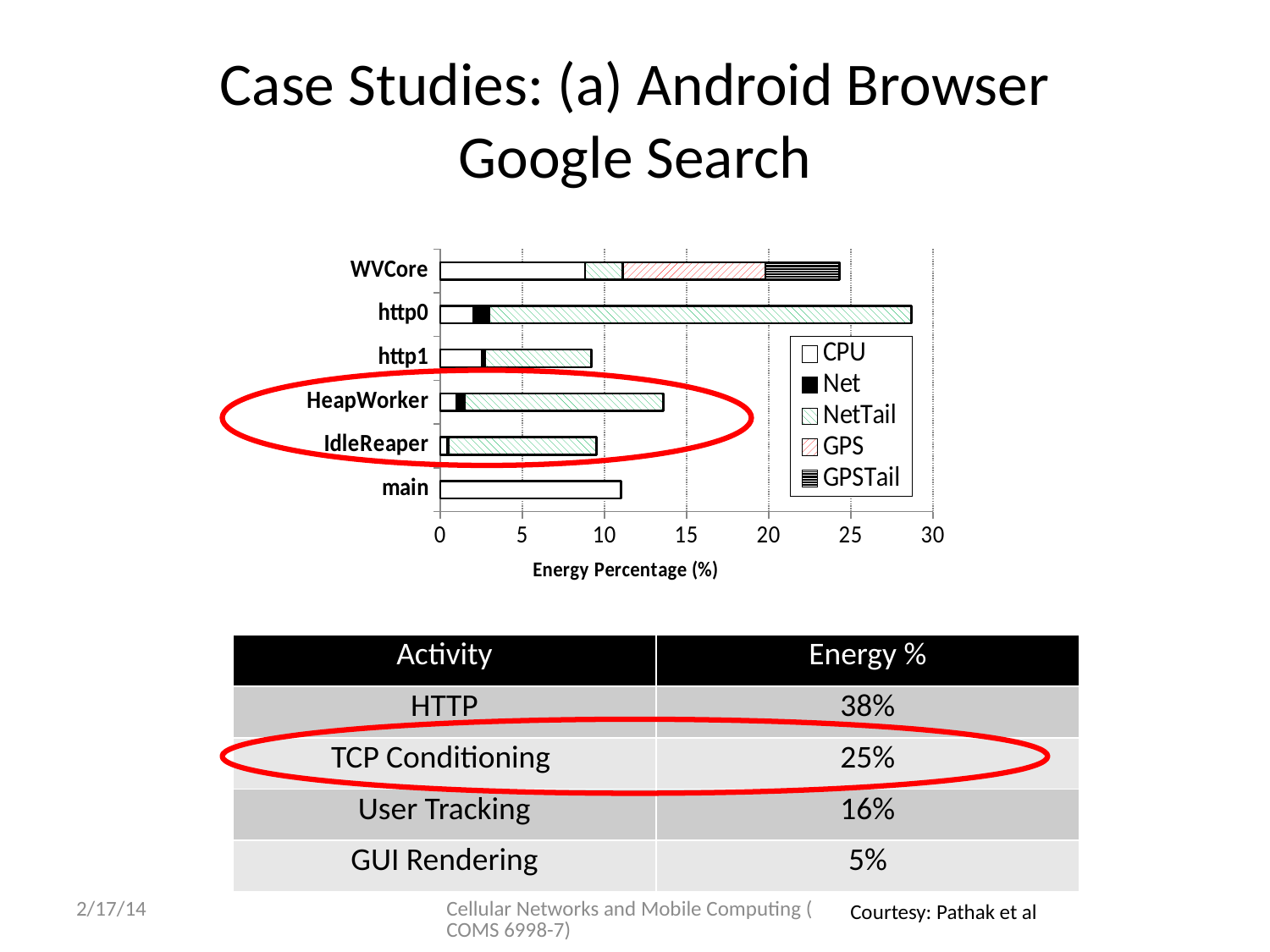
Is the total bar for WVCore greater or less than 20? greater Which has the longer total bar, HeapWorker or main? HeapWorker Is the total bar for main greater or less than 10? greater Is the total bar for http1 greater or less than 10? less What kind of chart is shown on the slide? bar chart How many series does the chart's legend list? 5 Which category has the longest total bar in the chart? http0 How many categories (threads) are plotted on the y axis of the chart? 6 What is the title of the chart's x axis? Energy Percentage (%) Which has the longer total bar, http0 or WVCore? http0